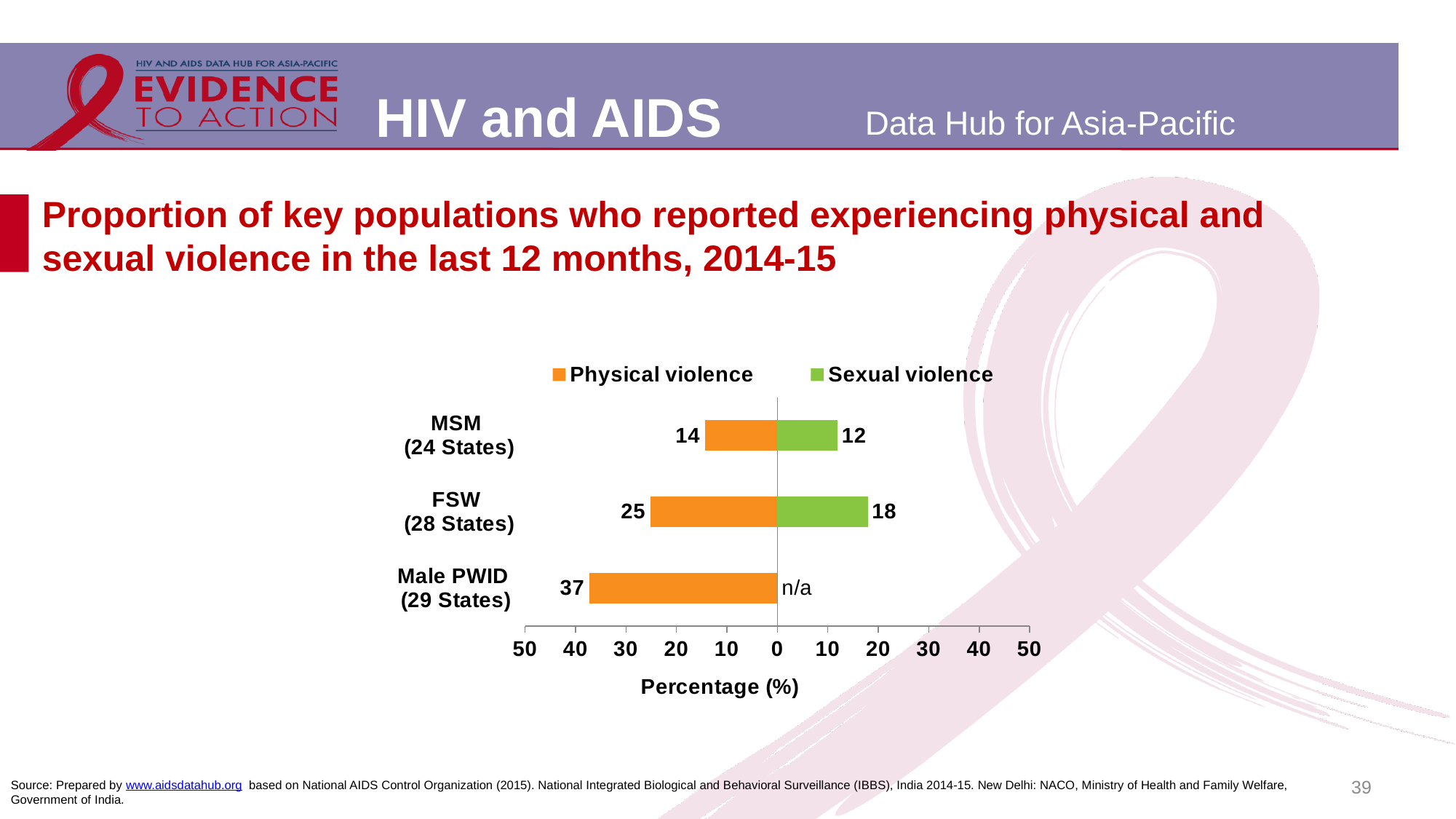
What is the Sexual violence value for MSM (24 States)? 12 What kind of chart is shown on the slide? Bar chart Which population has the lowest Physical violence value? MSM (24 States) What is the difference between the Physical violence and Sexual violence values for FSW (28 States)? 7 Which is larger for MSM (24 States): Physical violence or Sexual violence? Physical violence How many population groups are shown on the chart? 3 What is the Physical violence value for FSW (28 States)? 25 What is shown for Sexual violence for Male PWID (29 States)? n/a What is the Physical violence value for Male PWID (29 States)? 37 Which population has the highest Physical violence value? Male PWID (29 States) Is the Physical violence value for Male PWID (29 States) greater or less than 30? greater How many series does the legend list? 2